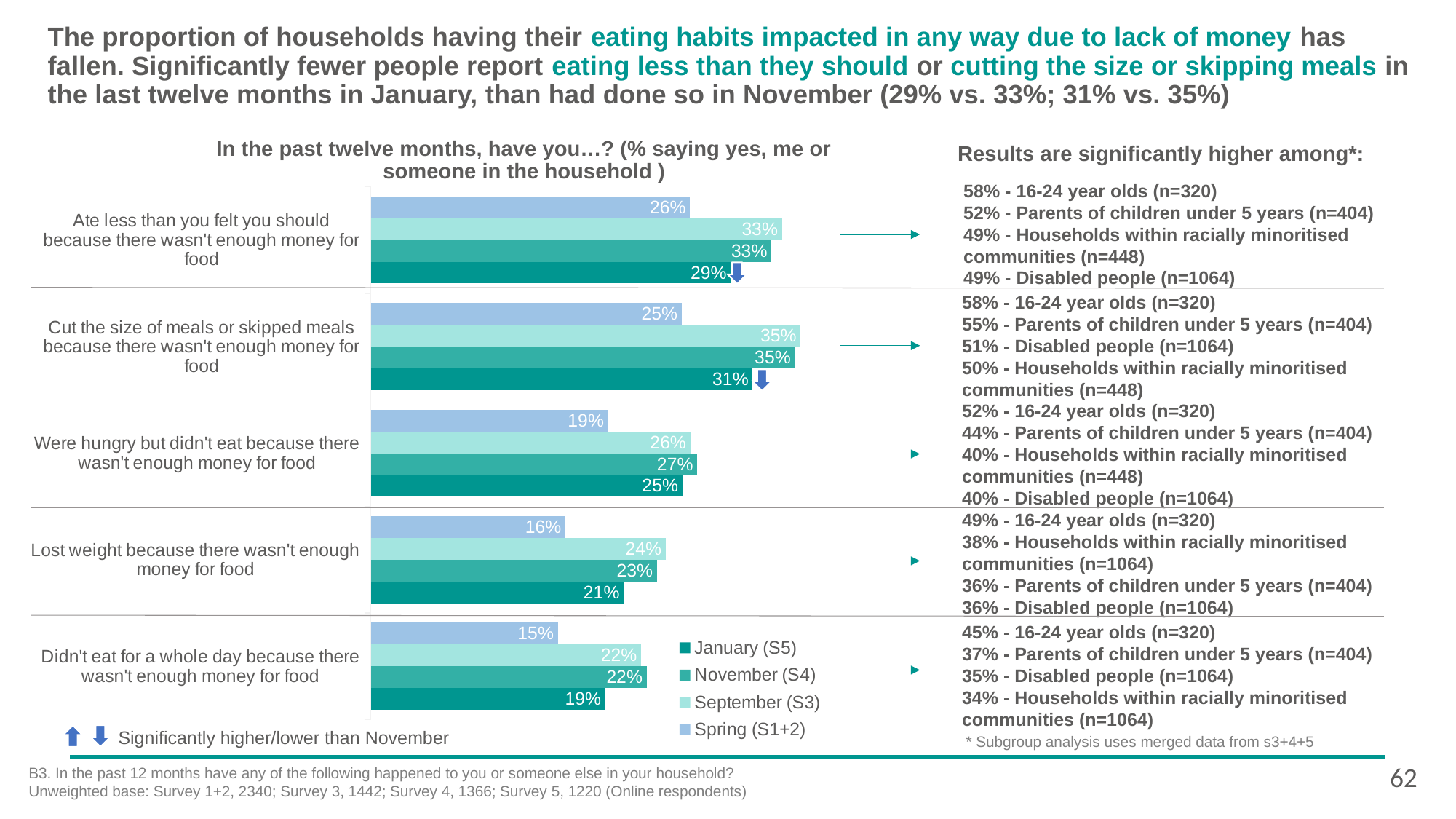
What is the January (S5) value for 'Ate less than you felt you should because there wasn't enough money for food'? 29% How many series does the chart legend list? 4 What is the difference between the November (S4) and January (S5) values for 'Cut the size of meals or skipped meals because there wasn't enough money for food'? 4 percentage points Which series is shown in the darkest teal colour in the legend? January (S5) What is the September (S3) value for 'Lost weight because there wasn't enough money for food'? 24% Which category has the lowest Spring (S1+2) value? Didn't eat for a whole day because there wasn't enough money for food What is the Spring (S1+2) value for 'Cut the size of meals or skipped meals because there wasn't enough money for food'? 25% For 'Didn't eat for a whole day because there wasn't enough money for food', which is larger: the September (S3) value or the January (S5) value? September (S3) What kind of chart is shown on the slide? bar chart What is the November (S4) value for 'Were hungry but didn't eat because there wasn't enough money for food'? 27% Which category has the highest January (S5) value? Cut the size of meals or skipped meals because there wasn't enough money for food How many categories (questions) are plotted in the chart? 5